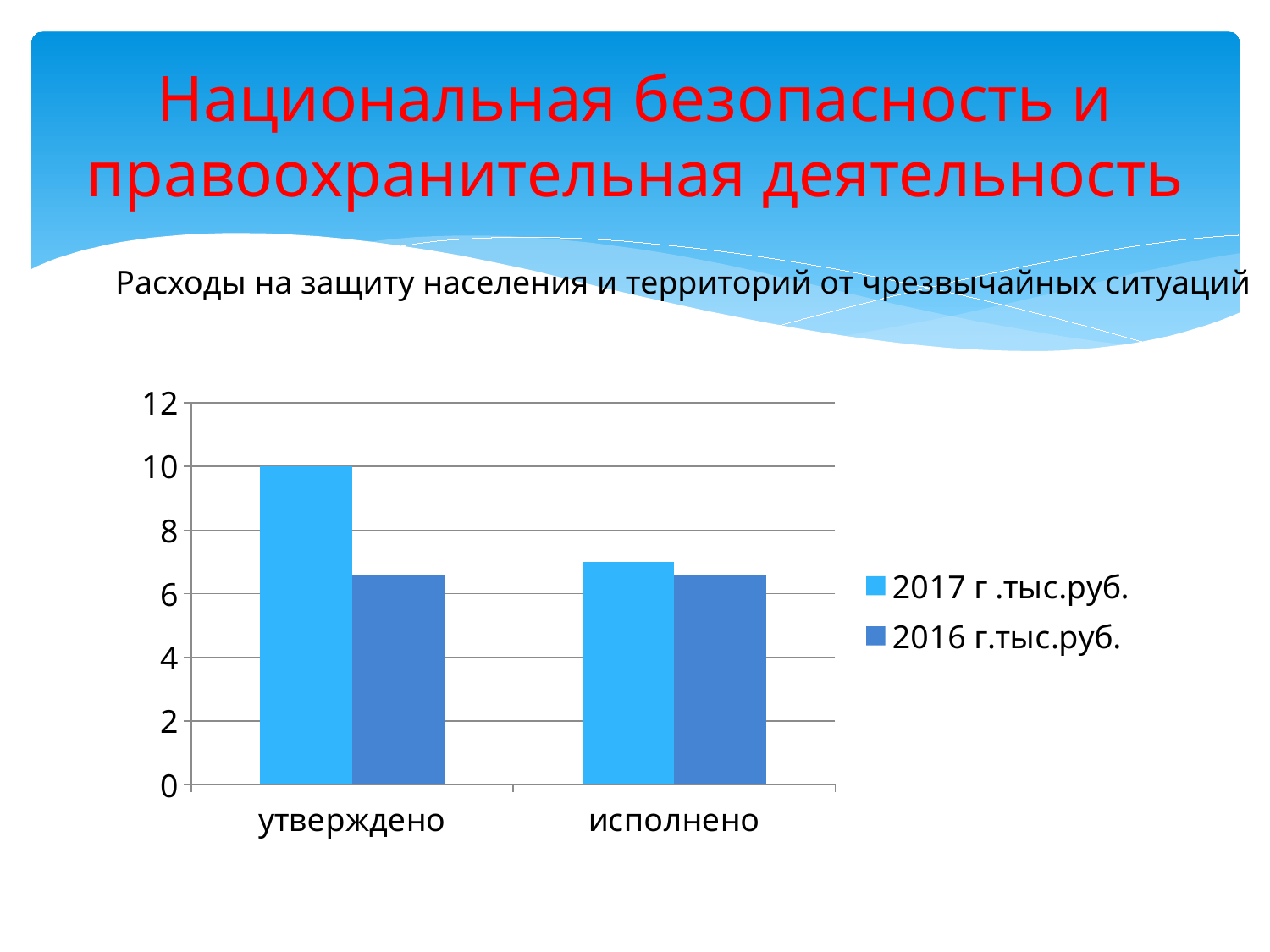
Do the values of the '2017 г .тыс.руб.' series rise or fall from 'утверждено' to 'исполнено'? fall What is the subtitle text above the chart describing the expenses shown? Расходы на защиту населения и территорий от чрезвычайных ситуаций For 'утверждено', which series has the larger value: '2017 г .тыс.руб.' or '2016 г.тыс.руб.'? 2017 г .тыс.руб. What type of chart is shown on the slide? bar chart Is the value for 'исполнено' in the '2016 г.тыс.руб.' series greater or less than 6? greater How many categories are shown on the x axis of the chart? 2 Which category has the highest value in the '2017 г .тыс.руб.' series? утверждено Is the value for 'исполнено' in the '2017 г .тыс.руб.' series greater or less than 6? greater How many series does the chart legend list? 2 Is the value for 'исполнено' in the '2017 г .тыс.руб.' series greater or less than 8? less What is the value for 'утверждено' in the '2017 г .тыс.руб.' series? 10